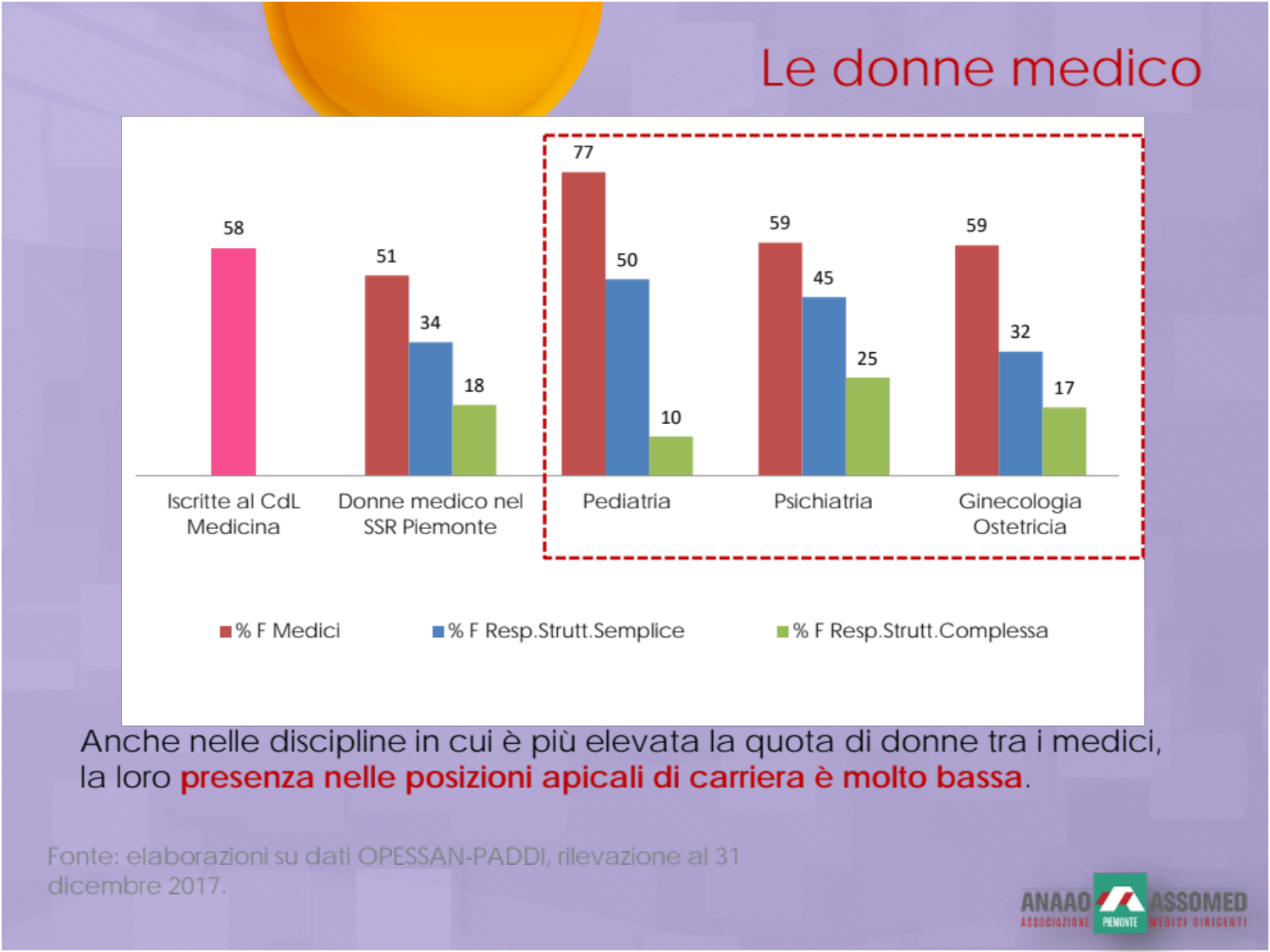
What is the value of % F Medici for Pediatria? 77 How many series does the legend list? 3 What is the value of % F Resp.Strutt.Complessa for Ginecologia Ostetricia? 17 What is the difference between % F Medici and % F Resp.Strutt.Complessa for Pediatria? 67 How many categories are shown on the x axis? 5 What is the value shown for Iscritte al CdL Medicina? 58 What is the difference between % F Resp.Strutt.Semplice for Psichiatria and for Ginecologia Ostetricia? 13 What kind of chart is shown on the slide? Bar chart Which category has the lowest % F Resp.Strutt.Complessa value? Pediatria Which is larger: % F Resp.Strutt.Semplice for Pediatria or for Psichiatria? Pediatria What is the value of % F Resp.Strutt.Semplice for Donne medico nel SSR Piemonte? 34 Which category has the highest % F Medici value? Pediatria